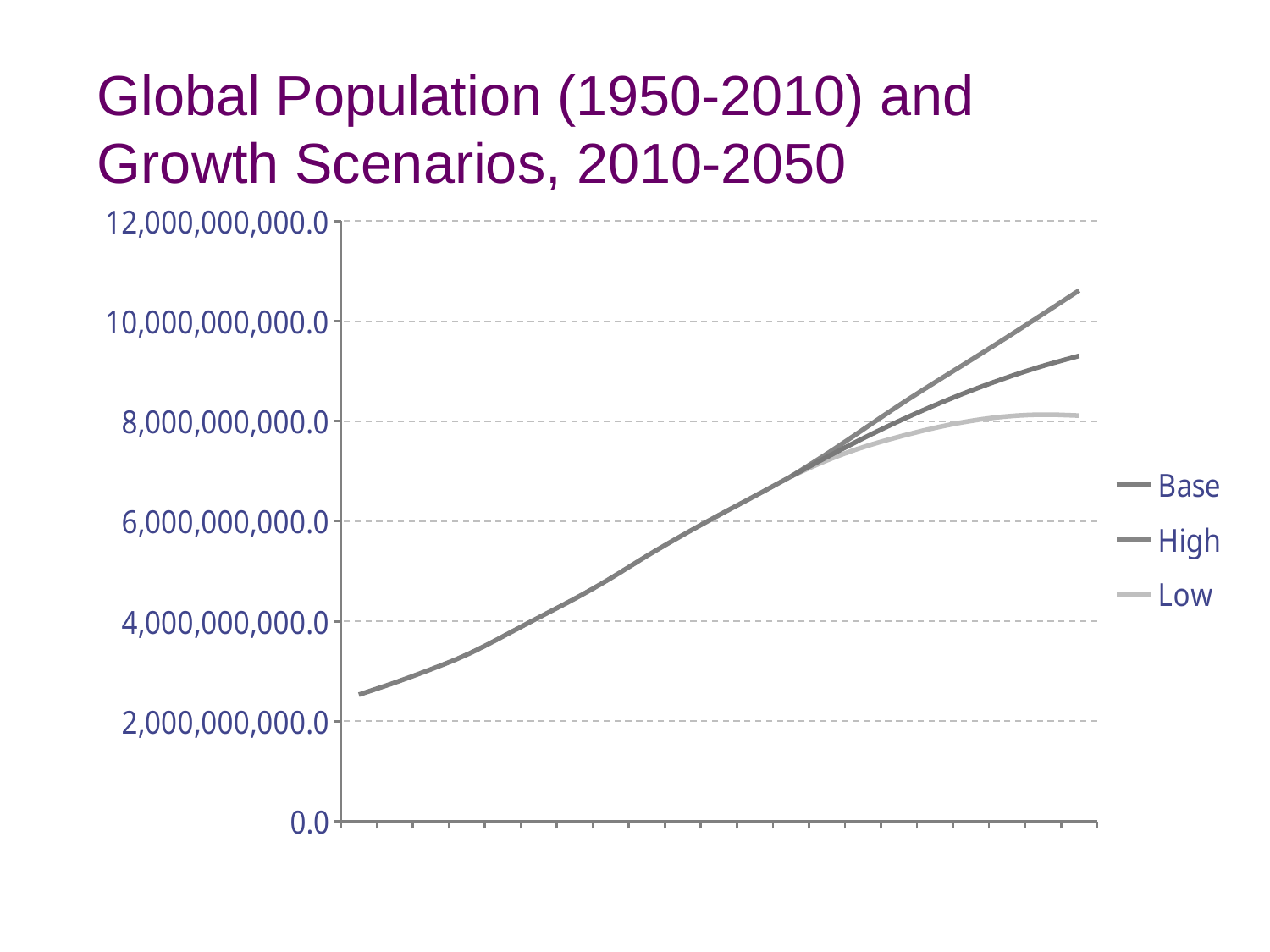
Which series has the lowest value at the right end of the chart? Low At the right end of the chart, is the High series or the Low series larger? High Does the High series rise or fall along the x axis? rise What are the three series named in the legend? Base, High, Low Which series reaches the highest value at the right end of the chart? High How many series does the legend list? 3 What is the title of the chart on the slide? Global Population (1950-2010) and Growth Scenarios, 2010-2050 Is the starting value at the left end of the lines greater or less than 4,000,000,000.0? less Is the final value of the High series greater or less than 10,000,000,000.0? greater What kind of chart is shown on the slide? line chart Is the final value of the Low series greater or less than 10,000,000,000.0? less